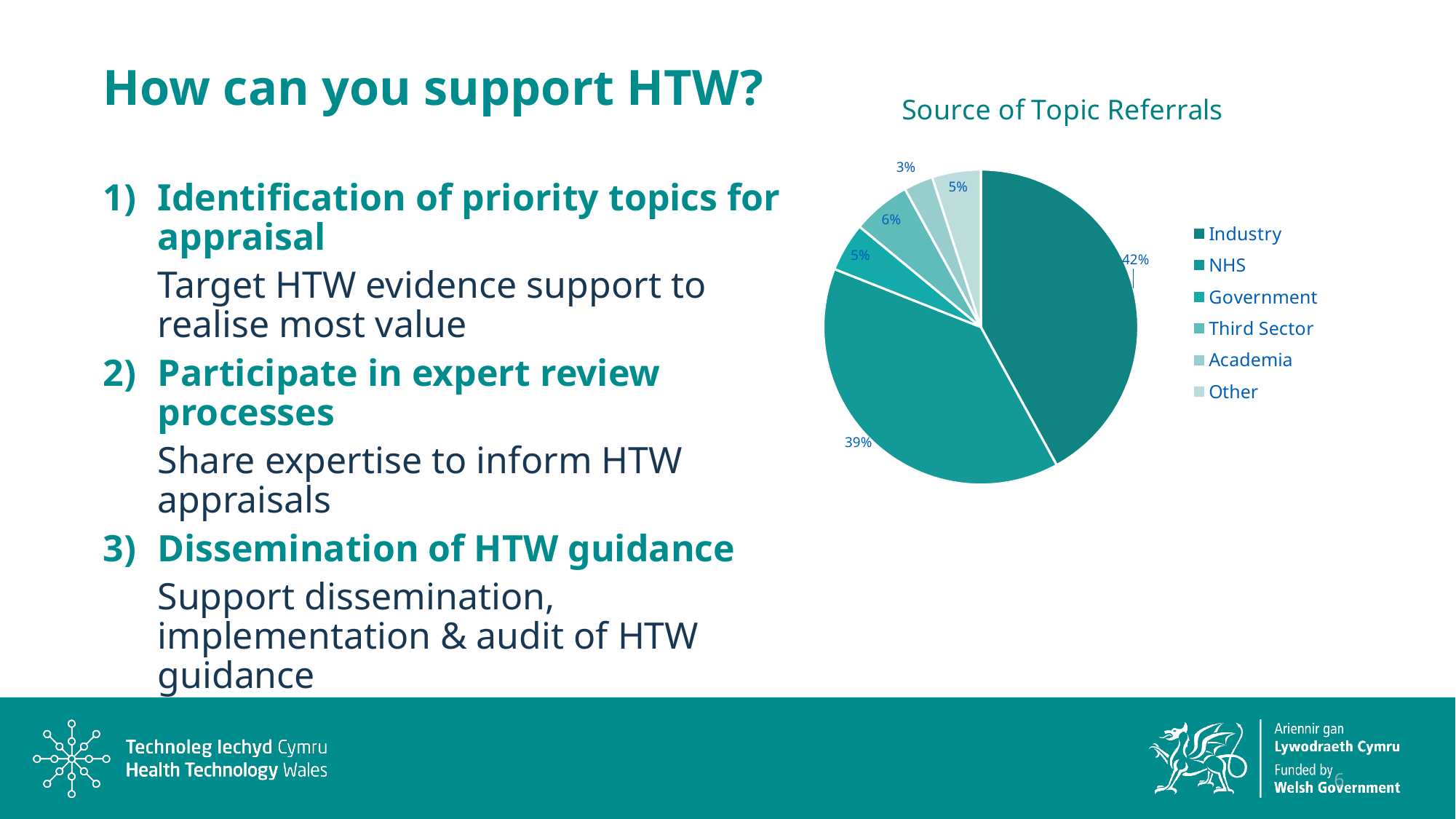
What is the combined share of Industry and NHS referrals? 81% What share of topic referrals comes from the NHS? 39% How many categories does the legend list? 6 Which source accounts for the smallest share of topic referrals? Academia What percentage of topic referrals comes from Academia? 3% Which is larger, the share for Third Sector or the share for Government? Third Sector What type of chart is shown on the slide? pie chart What percentage of topic referrals comes from the Third Sector? 6% What is the difference in percentage points between the Industry and NHS shares? 3 What share of topic referrals comes from Industry? 42% What is the title of the chart? Source of Topic Referrals Which source accounts for the largest share of topic referrals? Industry